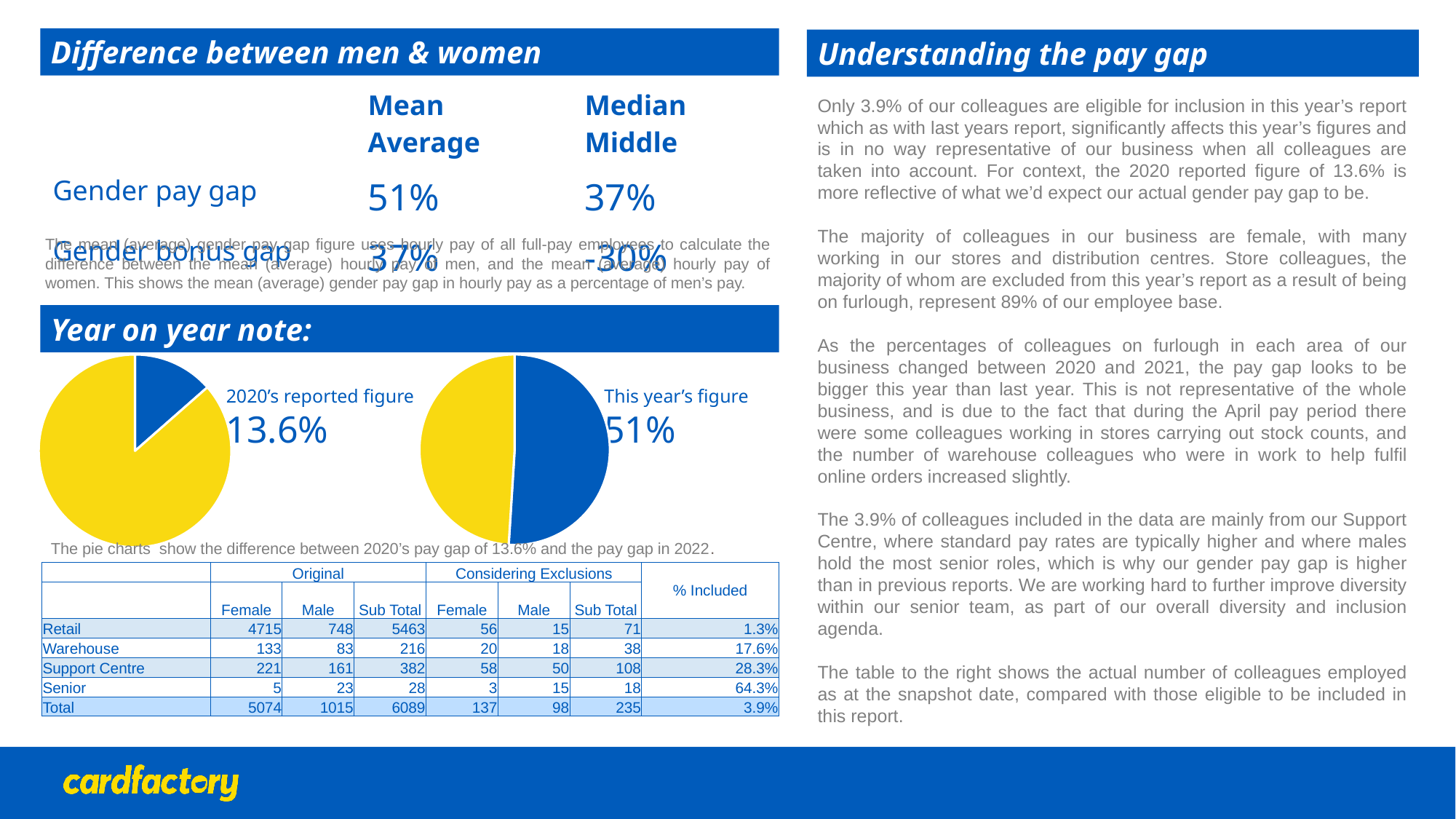
What figure is labelled next to the right pie chart for this year's figure? 51% What is the difference between this year's figure (51%) and 2020's reported figure (13.6%) shown beside the pie charts? 37.4% How many slices does each pie chart have? 2 What two colours are used for the slices in the pie charts? Yellow and blue What share of the left pie chart does the 2020 reported figure represent? 13.6% Which pie chart shows the higher figure, the 2020 reported figure pie or this year's figure pie? This year's figure In the left pie chart (2020's reported figure), is the blue slice larger or smaller than the yellow slice? Smaller What kind of charts are shown under the 'Year on year note' heading? Pie charts In the right pie chart (this year's figure), is the blue slice larger or smaller than the yellow slice? Larger How many pie charts are shown on the slide? 2 What figure is labelled next to the left pie chart for 2020's reported figure? 13.6% Which pie chart is labelled '2020's reported figure', the left one or the right one? The left one